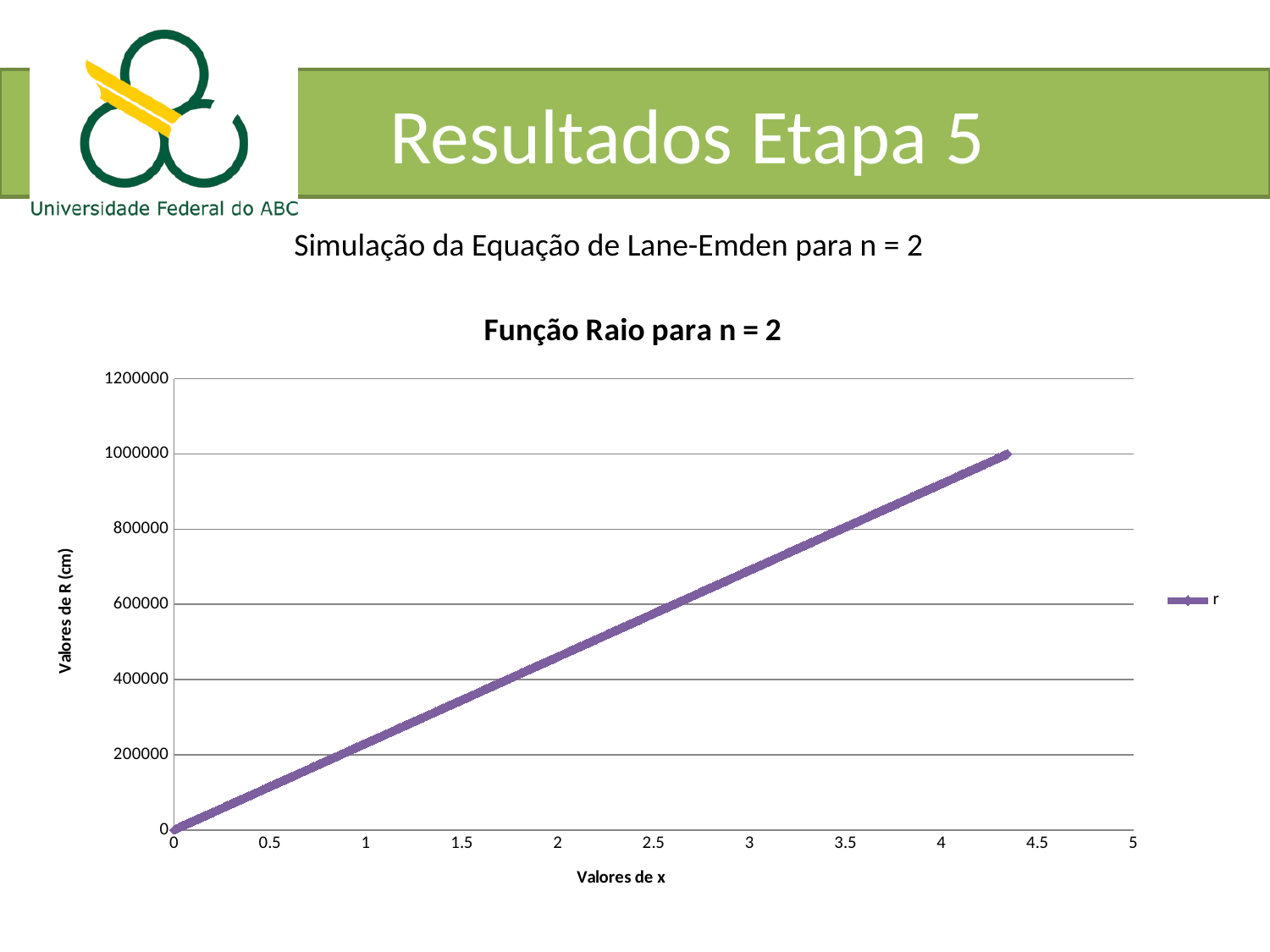
Which is larger, the value of r at x = 1 or at x = 3? x = 3 Is the value of r at x = 3 greater or less than 800000? less Is the value of r at x = 1 greater or less than 400000? less Is the value of r at x = 2 greater or less than 400000? greater What kind of chart is shown on the slide? line chart What is the name of the series shown in the legend? r What is the value of r at x = 0? 0 How many series does the legend list? 1 Do the values of r rise or fall as x increases? rise What is the highest tick value shown on the vertical axis? 1200000 What is the title of the chart? Função Raio para n = 2